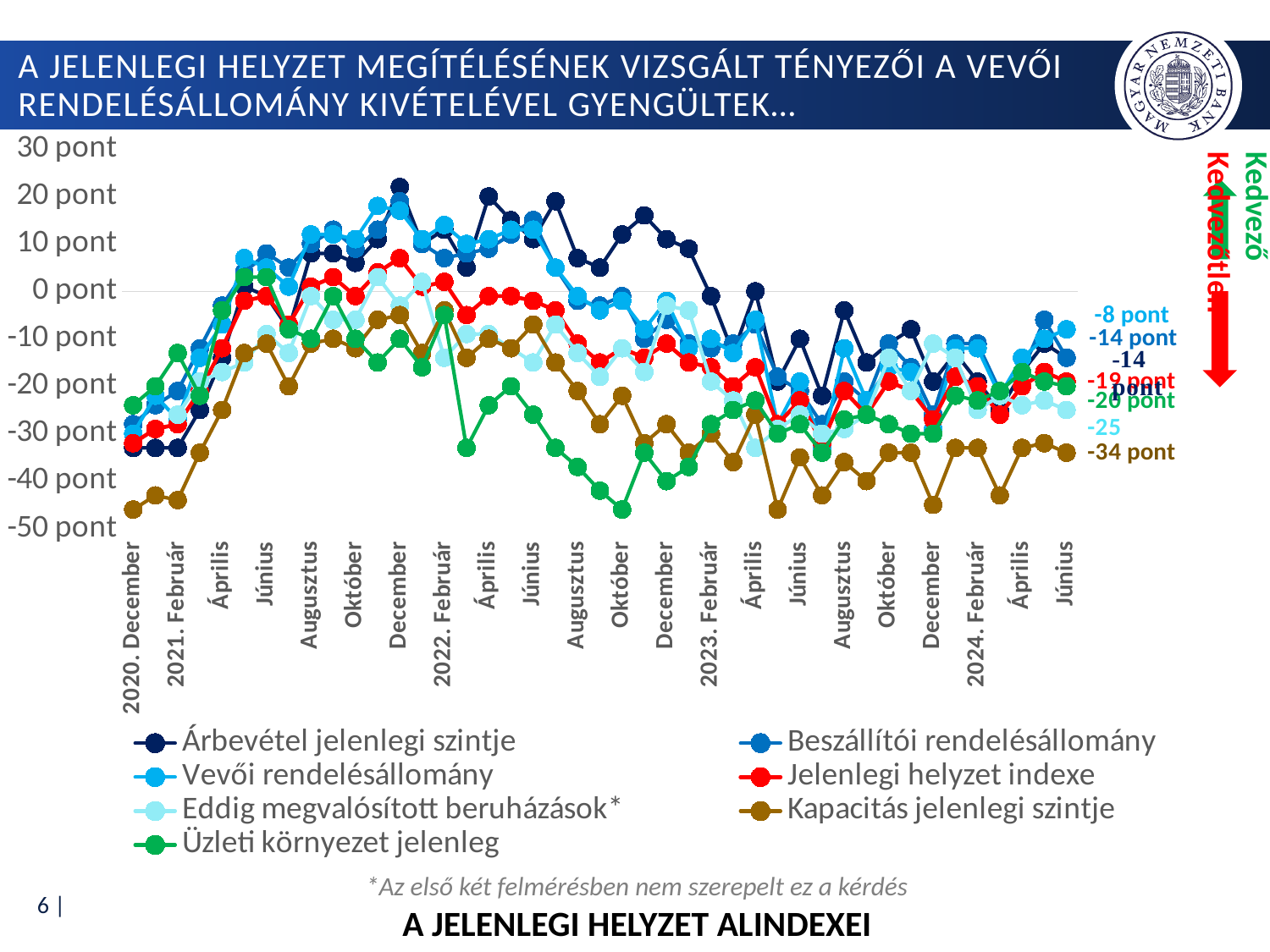
At the end of the chart, which is higher: Vevői rendelésállomány or Kapacitás jelenlegi szintje? Vevői rendelésállomány How many series does the legend list? 7 What is the difference between the final labelled values of Vevői rendelésállomány (-8 pont) and Kapacitás jelenlegi szintje (-34 pont)? 26 pont What is the latest value labelled for Kapacitás jelenlegi szintje? -34 pont What kind of chart is shown on the slide? line chart Which series has the highest value at the end of the chart (June 2024)? Vevői rendelésállomány What is the latest (June 2024) value labelled for Vevői rendelésállomány? -8 pont Is the value for Kapacitás jelenlegi szintje in 2020. December greater or less than -40 pont? less What is the latest value labelled for Üzleti környezet jelenleg? -20 pont What is the title of the chart shown at the bottom of the slide? A JELENLEGI HELYZET ALINDEXEI Which series has the lowest value at the end of the chart (June 2024)? Kapacitás jelenlegi szintje What is the latest value labelled for Jelenlegi helyzet indexe? -19 pont